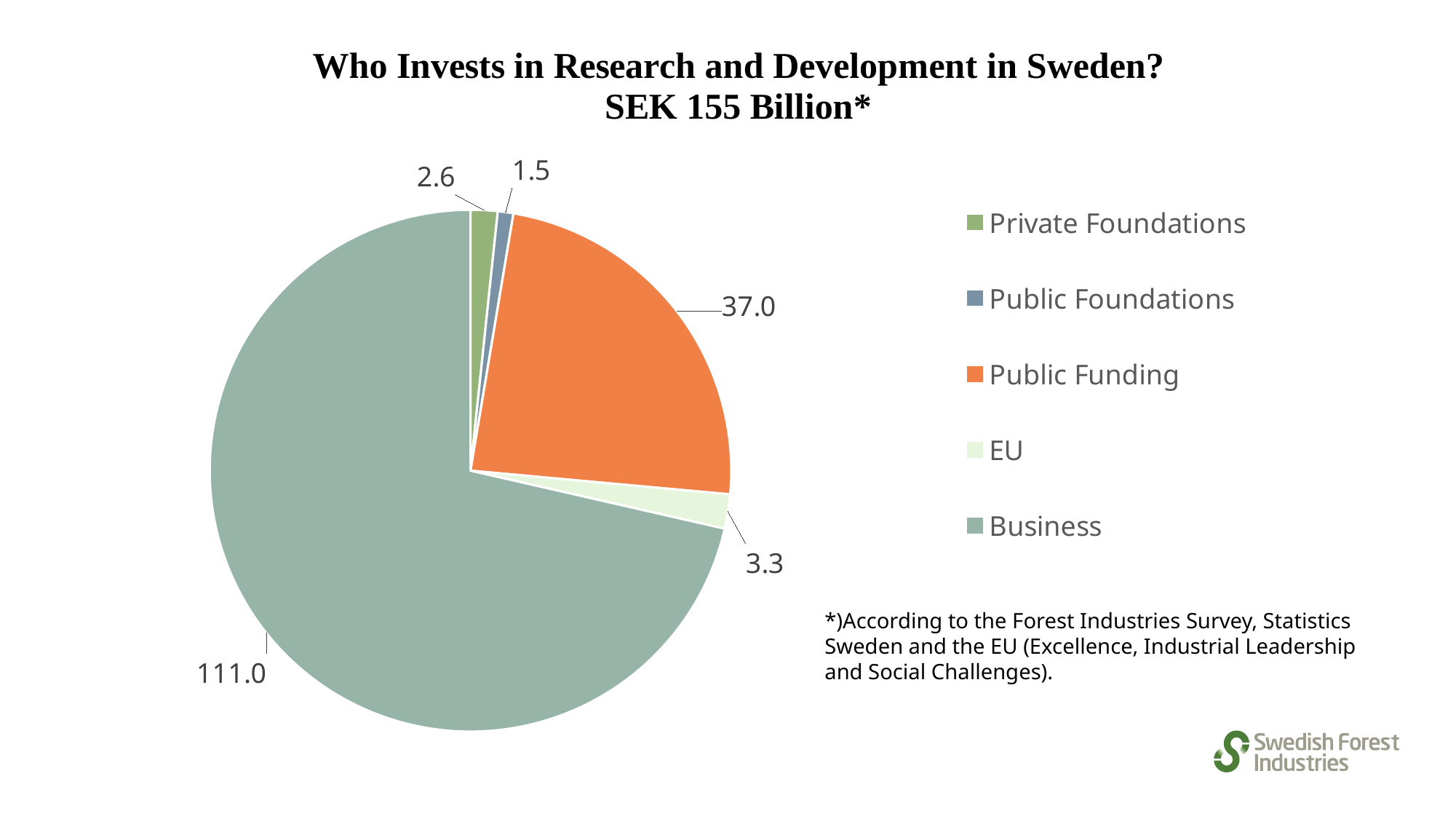
What value is shown for Private Foundations? 2.6 What value is shown for the EU slice? 3.3 What value is shown for Business? 111.0 What is the difference between the values for Business and Public Funding? 74.0 How many categories does the pie chart show? 5 What kind of chart is shown on the slide? Pie chart Which category has the smallest slice of the pie? Public Foundations Which is larger, the value for EU or the value for Private Foundations? EU What value is shown for Public Foundations? 1.5 What value is shown for Public Funding? 37.0 Which category has the largest slice of the pie? Business What colour is the Public Funding slice? Orange